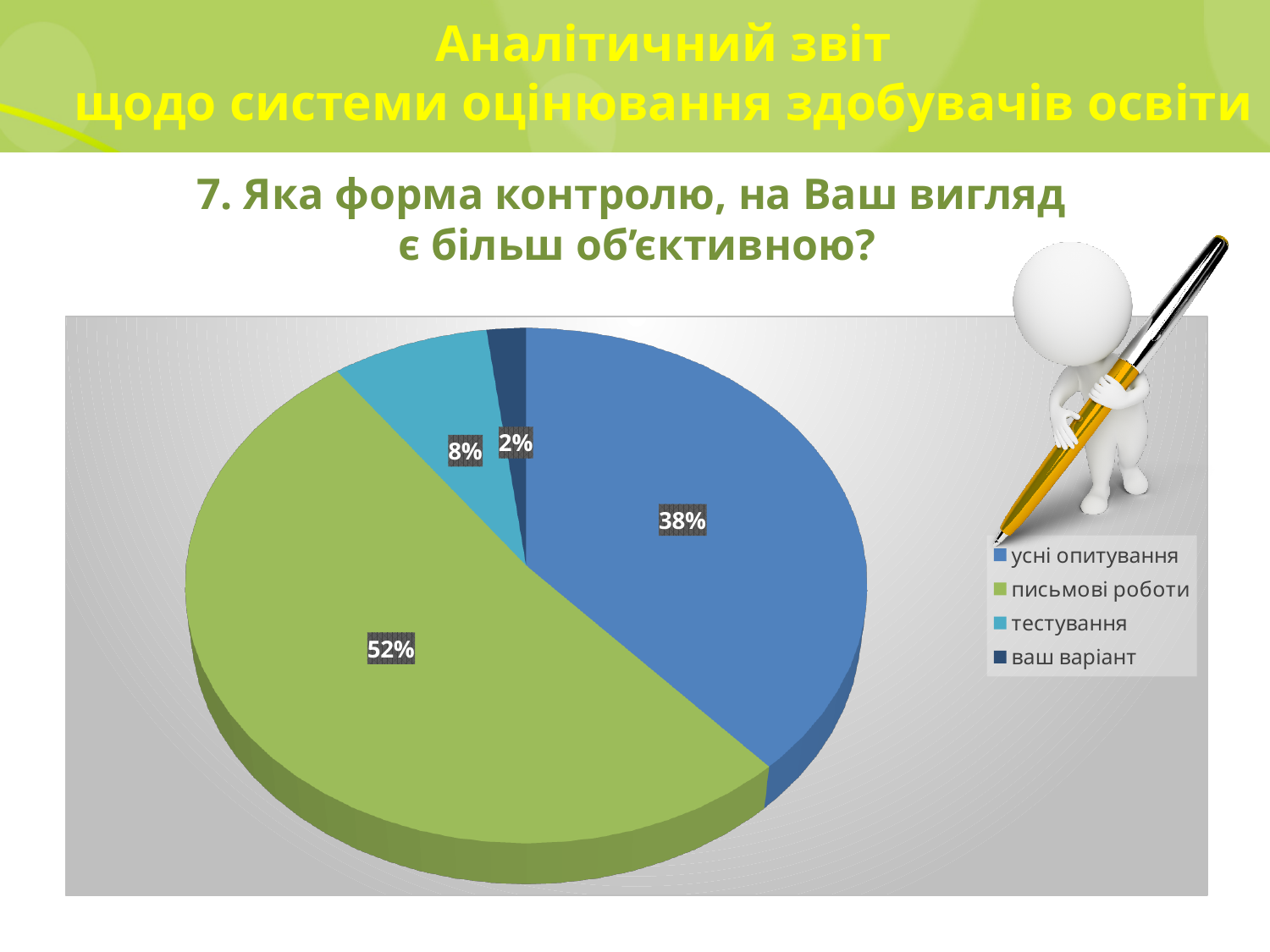
What kind of chart is shown on the slide? pie chart What is the value shown for "усні опитування"? 38% How many categories does the pie chart show? 4 Which category has the largest slice of the pie? письмові роботи What is the difference between the values for "письмові роботи" and "усні опитування"? 14% What is the value shown for "тестування"? 8% What is the value shown for "ваш варіант"? 2% Which category has the smallest slice of the pie? ваш варіант What colour is the slice for "усні опитування"? blue What share of the pie does "письмові роботи" have? 52% Which is larger, the value for "тестування" or the value for "ваш варіант"? тестування What is the difference between the values for "тестування" and "ваш варіант"? 6%